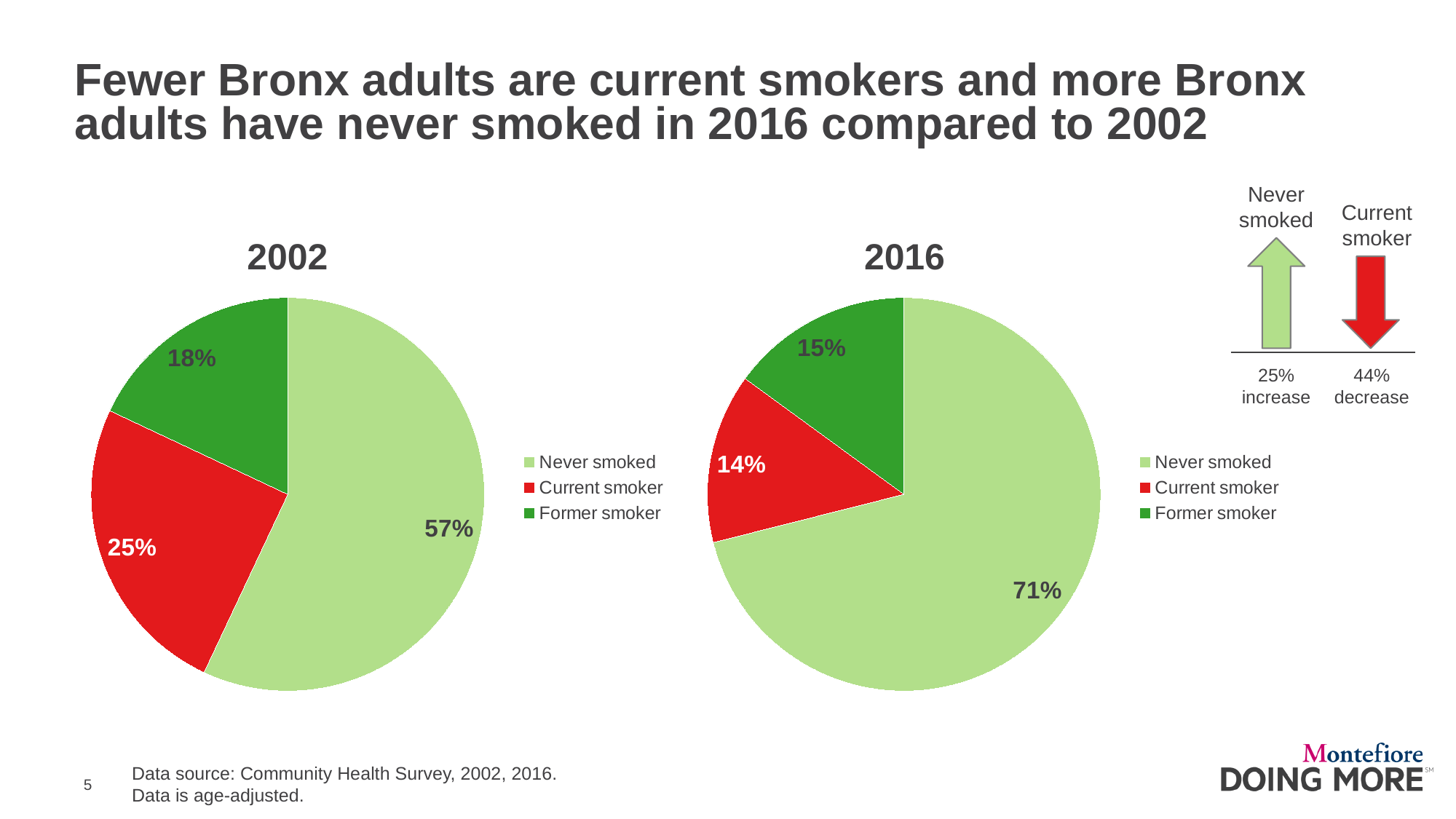
In the 2016 pie chart, which colour represents Current smoker? Red In the 2016 pie chart, which category has the smallest share? Current smoker Is the Current smoker share larger in the 2002 pie chart or the 2016 pie chart? 2002 In the 2016 pie chart, what percentage of Bronx adults were current smokers? 14% How many categories does the 2016 pie chart show? 3 In the 2002 pie chart, what is the value for Former smoker? 18% In the 2016 pie chart, what is the value for Former smoker? 15% What type of chart is used to show the 2002 data? Pie chart In the 2002 pie chart, what is the difference between the Current smoker and Former smoker shares? 7% What is the difference between the Never smoked share in 2016 and in 2002? 14% In the 2002 pie chart, which category has the largest share? Never smoked In the 2002 pie chart, what percentage of Bronx adults had never smoked? 57%